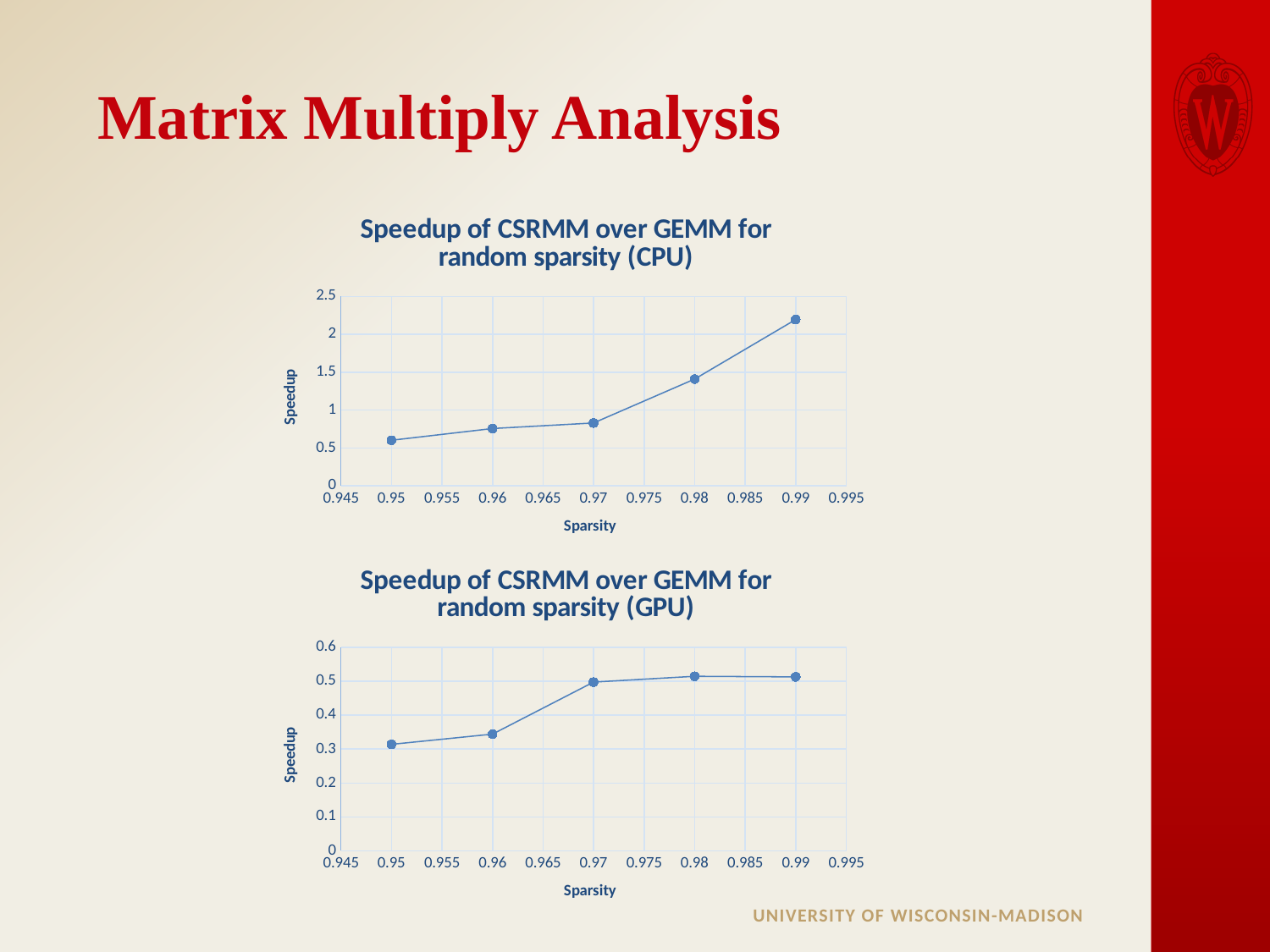
In the GPU chart, which has the larger speedup: sparsity 0.96 or sparsity 0.97? 0.97 How many data points are plotted in the 'Speedup of CSRMM over GEMM for random sparsity (GPU)' chart? 5 In the GPU chart, at which sparsity value is the speedup lowest? 0.95 In the CPU chart, at which sparsity value is the speedup lowest? 0.95 What kind of chart is the 'Speedup of CSRMM over GEMM for random sparsity (CPU)' chart? line chart In the CPU chart, which has the larger speedup: sparsity 0.97 or sparsity 0.98? 0.98 In the CPU chart, at which sparsity value is the speedup highest? 0.99 In the GPU chart, is the speedup at sparsity 0.95 greater or less than 0.4? less What is the label of the x axis on the GPU chart? Sparsity In the CPU chart, is the speedup at sparsity 0.99 greater or less than 2? greater In the CPU chart, is the speedup at sparsity 0.95 greater or less than 1? less In the CPU chart, does the speedup rise or fall as sparsity increases? rise